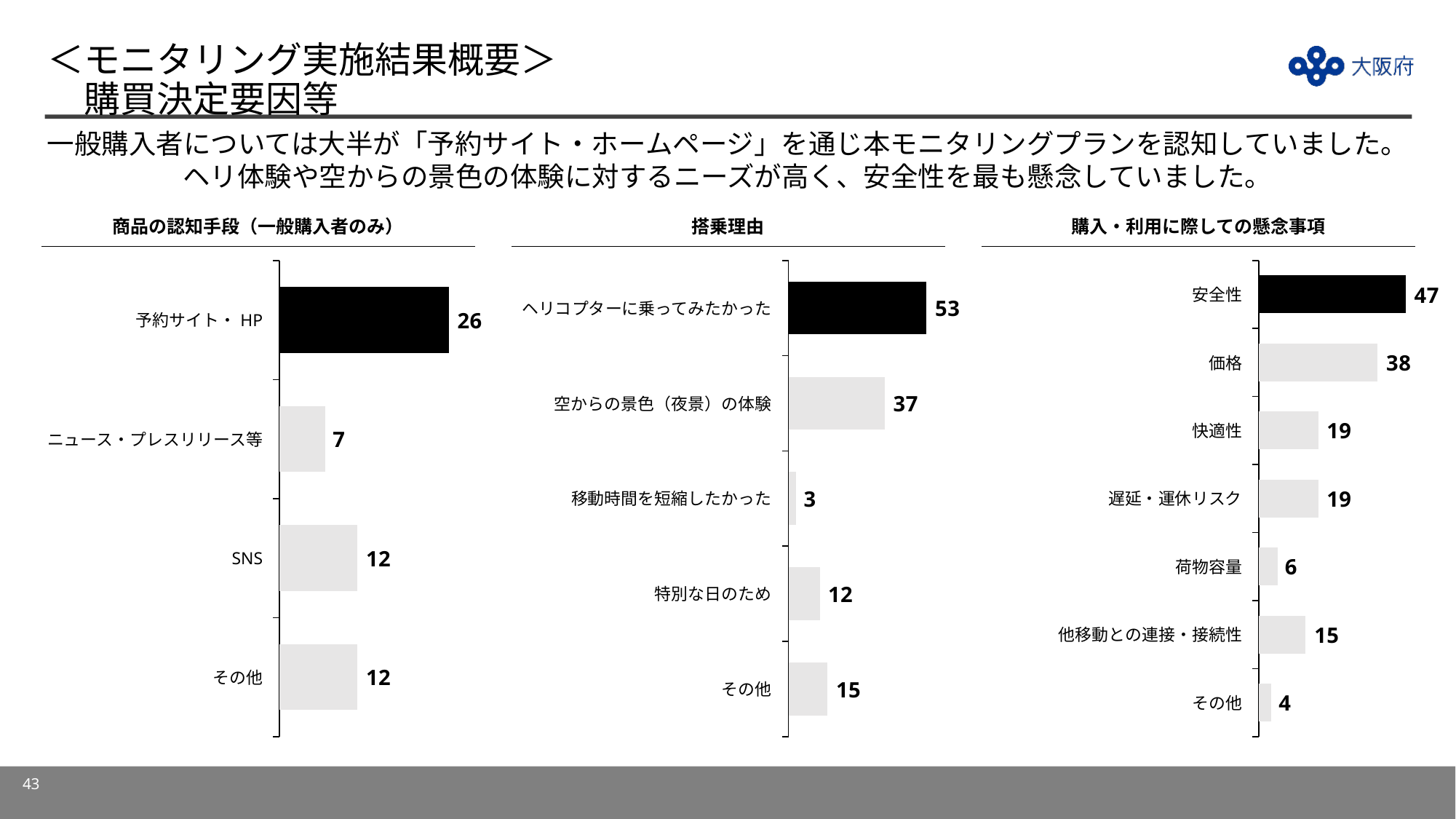
In the chart titled 購入・利用に際しての懸念事項, how many categories are shown? 7 In the chart titled 購入・利用に際しての懸念事項, what is the difference between 安全性 and 荷物容量? 41 In the chart titled 購入・利用に際しての懸念事項, which category has the lowest value? その他 In the chart titled 商品の認知手段（一般購入者のみ）, what is the value for 予約サイト・HP? 26 In the chart titled 商品の認知手段（一般購入者のみ）, how many categories are shown? 4 What type of chart is the chart titled 搭乗理由? Bar chart In the chart titled 搭乗理由, what is the value for 空からの景色（夜景）の体験? 37 In the chart titled 購入・利用に際しての懸念事項, what is the value for 価格? 38 In the chart titled 商品の認知手段（一般購入者のみ）, which category has the lowest value? ニュース・プレスリリース等 In the chart titled 搭乗理由, which category has the highest value? ヘリコプターに乗ってみたかった In the chart titled 搭乗理由, what is the difference between ヘリコプターに乗ってみたかった and 空からの景色（夜景）の体験? 16 In the chart titled 搭乗理由, which is larger: 特別な日のため or その他? その他